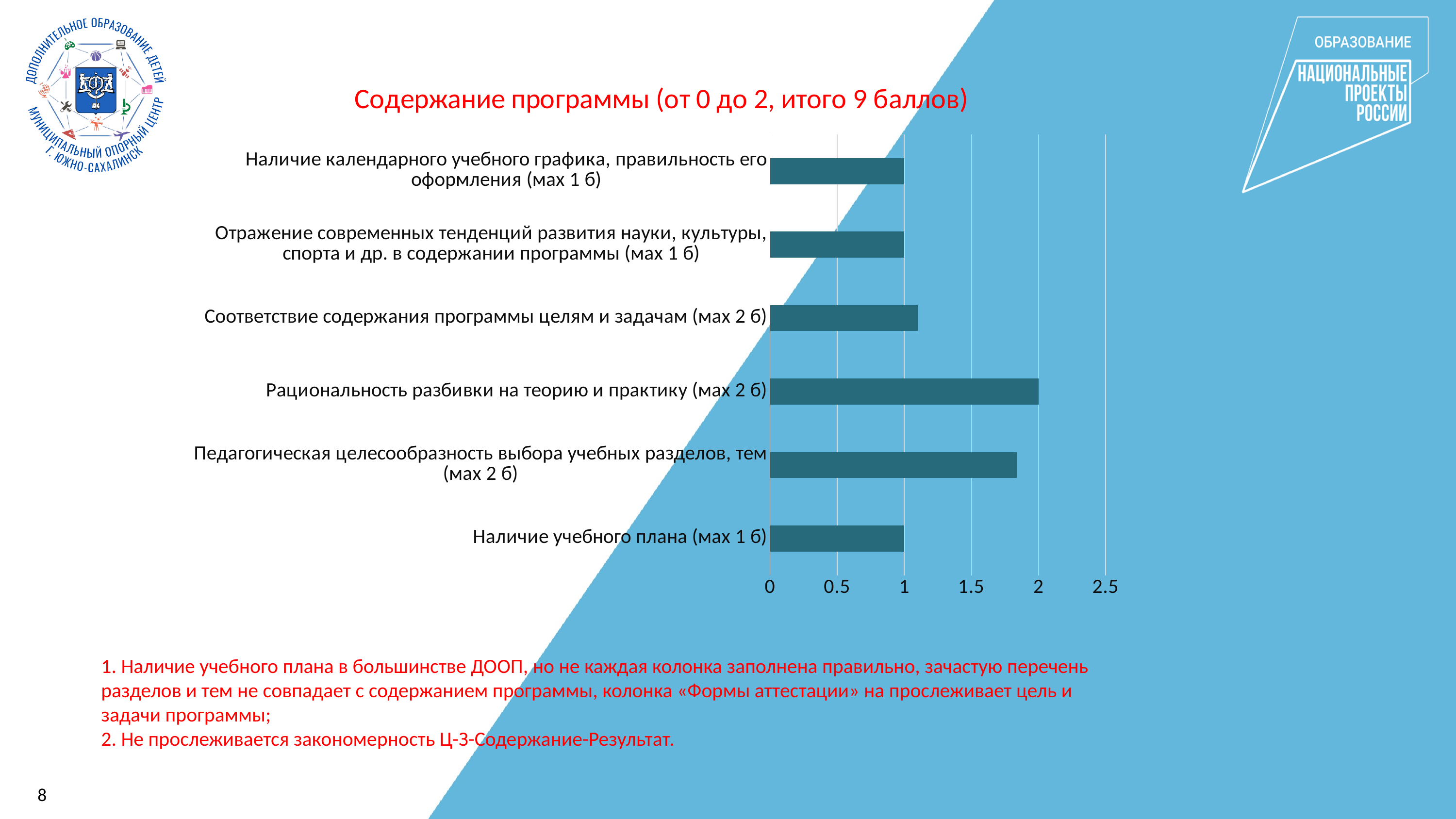
What is the value for "Наличие учебного плана (мах 1 б)"? 1 Which category has the highest value in the chart? Рациональность разбивки на теорию и практику (мах 2 б) What is the value for "Рациональность разбивки на теорию и практику (мах 2 б)"? 2 Is the value for "Соответствие содержания программы целям и задачам (мах 2 б)" greater or less than 1.5? less What is the value for "Отражение современных тенденций развития науки, культуры, спорта и др. в содержании программы (мах 1 б)"? 1 What is the largest tick value shown on the horizontal axis of the chart? 2.5 How many categories are plotted in the chart? 6 Which is larger: the value for "Рациональность разбивки на теорию и практику (мах 2 б)" or for "Педагогическая целесообразность выбора учебных разделов, тем (мах 2 б)"? Рациональность разбивки на теорию и практику (мах 2 б) What is the value for "Наличие календарного учебного графика, правильность его оформления (мах 1 б)"? 1 Is the value for "Педагогическая целесообразность выбора учебных разделов, тем (мах 2 б)" greater or less than 1.5? greater What kind of chart is shown on the slide? bar chart What is the title of the chart on the slide? Содержание программы (от 0 до 2, итого 9 баллов)